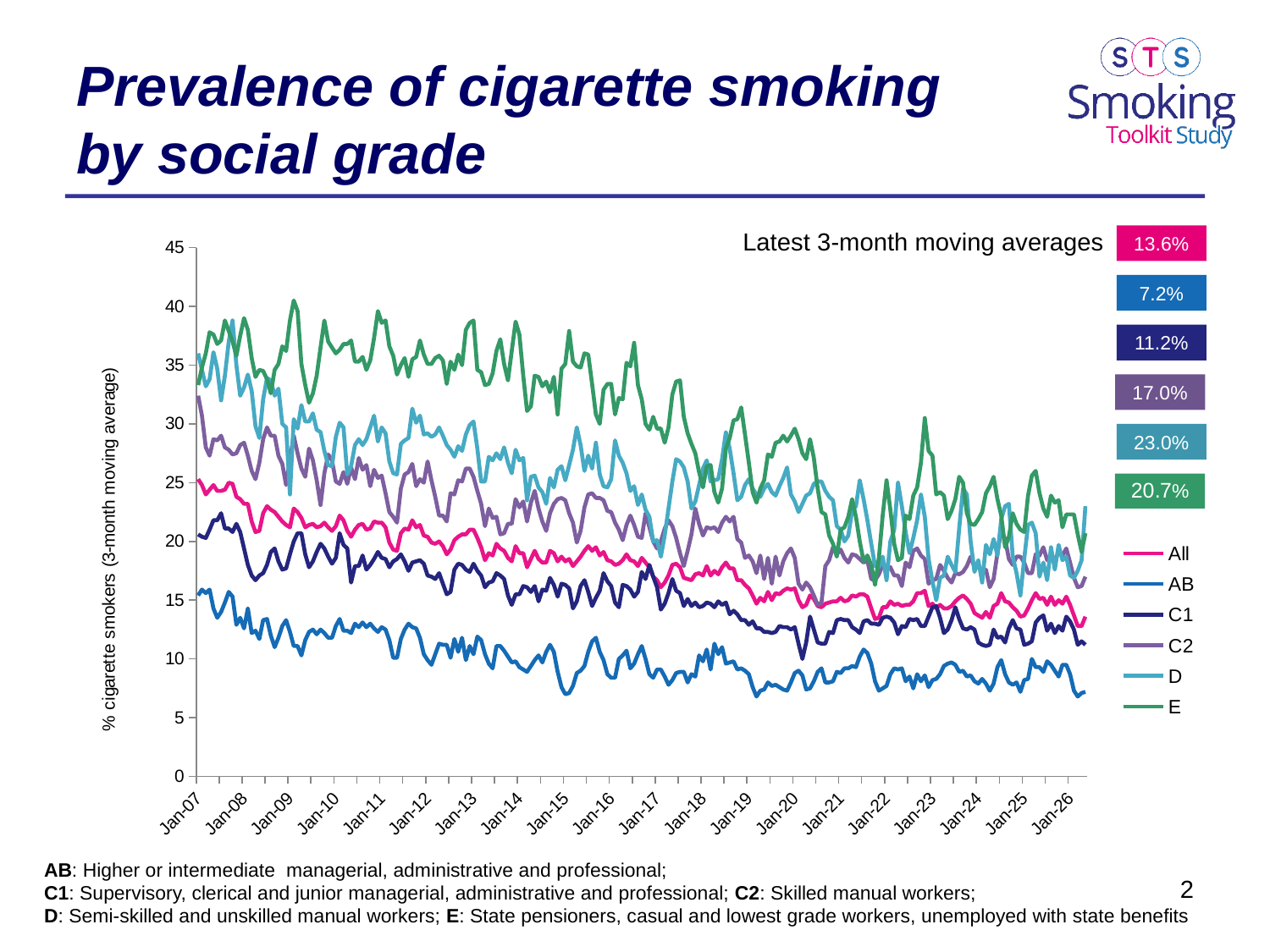
How many series does the legend list? 6 Which social grade has the highest latest 3-month moving average? D Which has a higher latest 3-month moving average, social grade C2 or social grade E? E What is the difference between the latest 3-month moving averages for social grades D and AB? 15.8 percentage points What is the latest 3-month moving average for social grade D? 23.0% Is the value for social grade E at Jan-07 greater or less than 30? greater Does the smoking prevalence for the 'All' series rise or fall from Jan-07 to Jan-26? Fall What is the latest 3-month moving average for the AB social grade? 7.2% Which social grade has the lowest latest 3-month moving average? AB What is the label of the vertical axis? % cigarette smokers (3-month moving average) What kind of chart is shown on the slide? Line chart What is the latest 3-month moving average for all smokers (the 'All' series)? 13.6%